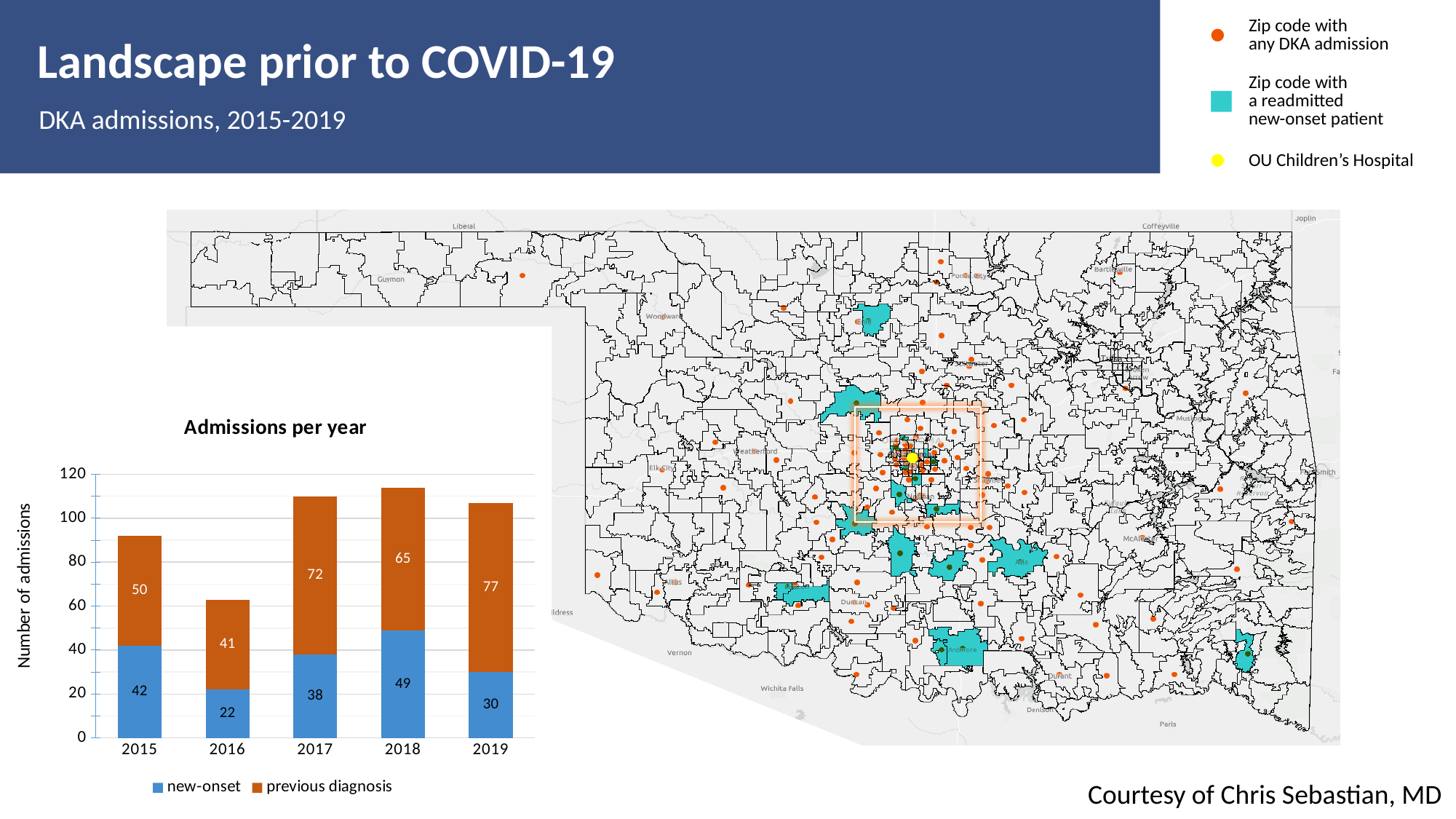
In the 'Admissions per year' chart, what is the difference between the new-onset values for 2018 and 2016? 27 In the 'Admissions per year' chart, is the total stacked bar for 2018 greater or less than 100? greater In the 'Admissions per year' chart, what is the previous diagnosis value for 2017? 72 What kind of chart is 'Admissions per year'? stacked bar chart How many series does the legend of the 'Admissions per year' chart list? 2 In the 'Admissions per year' chart, what is the total of the stacked bar for 2015? 92 In the 'Admissions per year' chart, which year has the highest previous diagnosis value? 2019 What is the y-axis label of the 'Admissions per year' chart? Number of admissions In the 'Admissions per year' chart, which year has the lowest new-onset value? 2016 In the 'Admissions per year' chart, what is the new-onset value for 2018? 49 In the 'Admissions per year' chart, is the new-onset value for 2017 larger than the new-onset value for 2019? Yes How many years are shown on the x axis of the 'Admissions per year' chart? 5